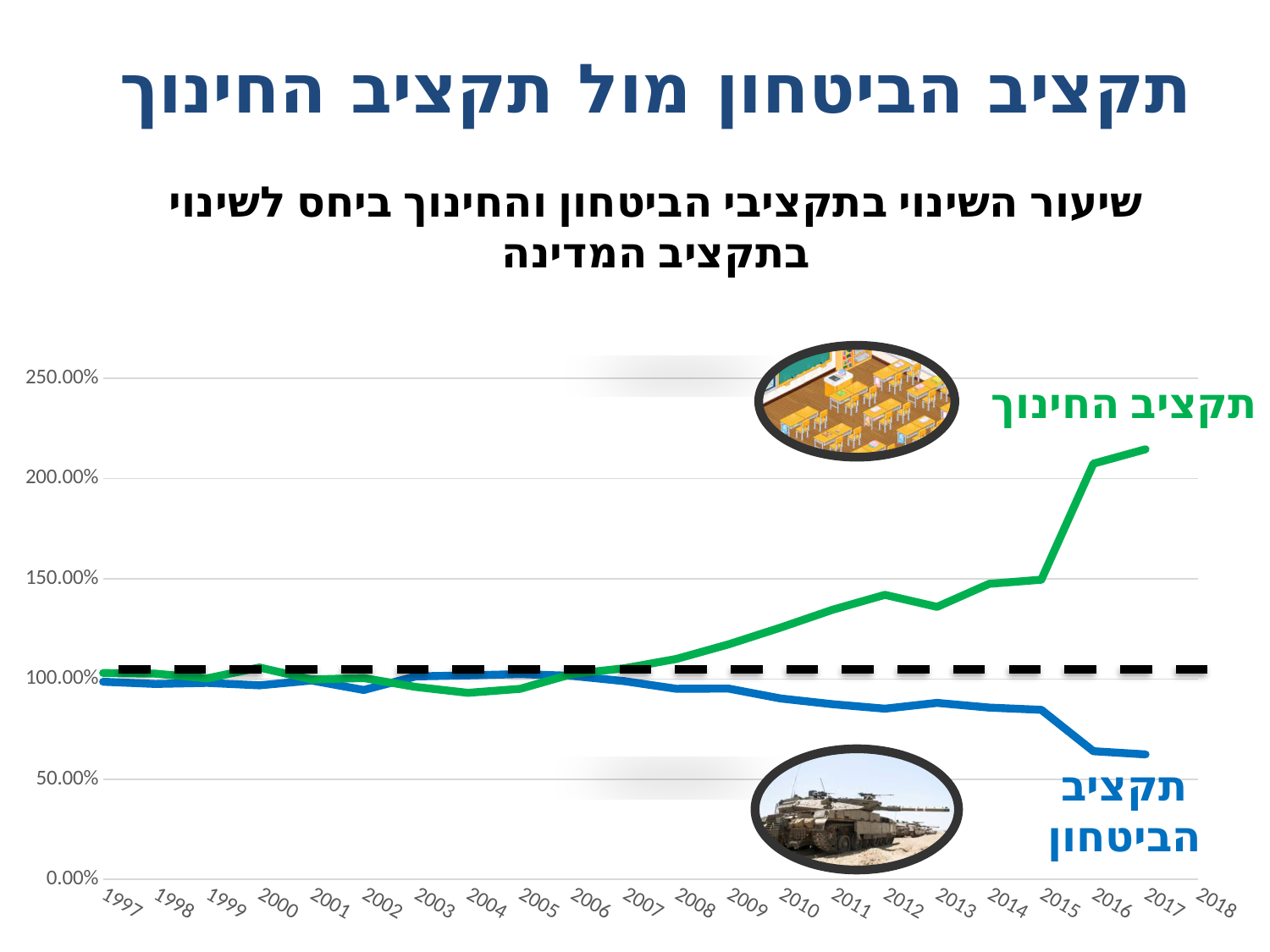
Is the value of תקציב החינוך (education budget) in 2012 greater or less than 100.00%? greater How many data series are plotted on the chart? 2 What kind of chart is shown on the slide? line chart How many years are labelled along the x axis of the chart? 22 Is the value of תקציב החינוך (education budget) in 2017 greater or less than 200.00%? greater In 2017, which series has the higher value, תקציב החינוך or תקציב הביטחון? תקציב החינוך What is the first year shown on the x axis? 1997 In which year does the תקציב החינוך (education budget) line reach its highest value? 2017 Is the value of תקציב הביטחון (defense budget) in 2016 greater or less than 100.00%? less Does the תקציב הביטחון (defense budget) line rise or fall between 2010 and 2017? fall Does the תקציב החינוך (education budget) line rise or fall between 2007 and 2017? rise